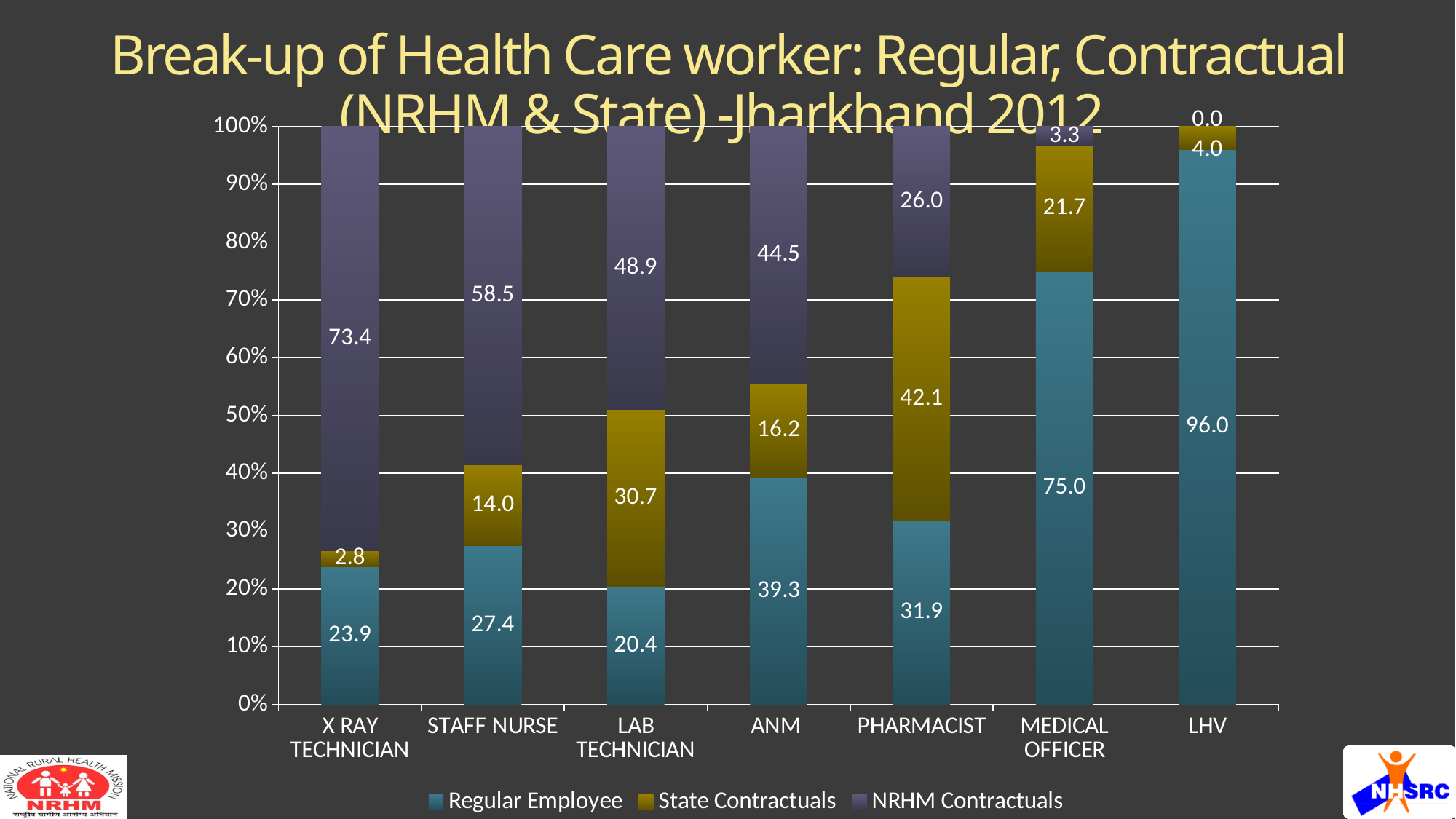
Which category has the lowest Regular Employee value? LAB TECHNICIAN How many series does the legend list? 3 Which legend entry is shown in the teal colour at the bottom of each bar? Regular Employee How many health care worker categories are shown on the x axis? 7 What is the Regular Employee value for MEDICAL OFFICER? 75.0 What is the difference between the Regular Employee values for MEDICAL OFFICER and ANM? 35.7 What kind of chart is shown on the slide? Stacked bar chart Which category has the highest Regular Employee value? LHV Which category has the lowest State Contractuals value? LHV What is the NRHM Contractuals value for X RAY TECHNICIAN? 73.4 Which has the larger NRHM Contractuals value, STAFF NURSE or LAB TECHNICIAN? STAFF NURSE What is the State Contractuals value for PHARMACIST? 42.1